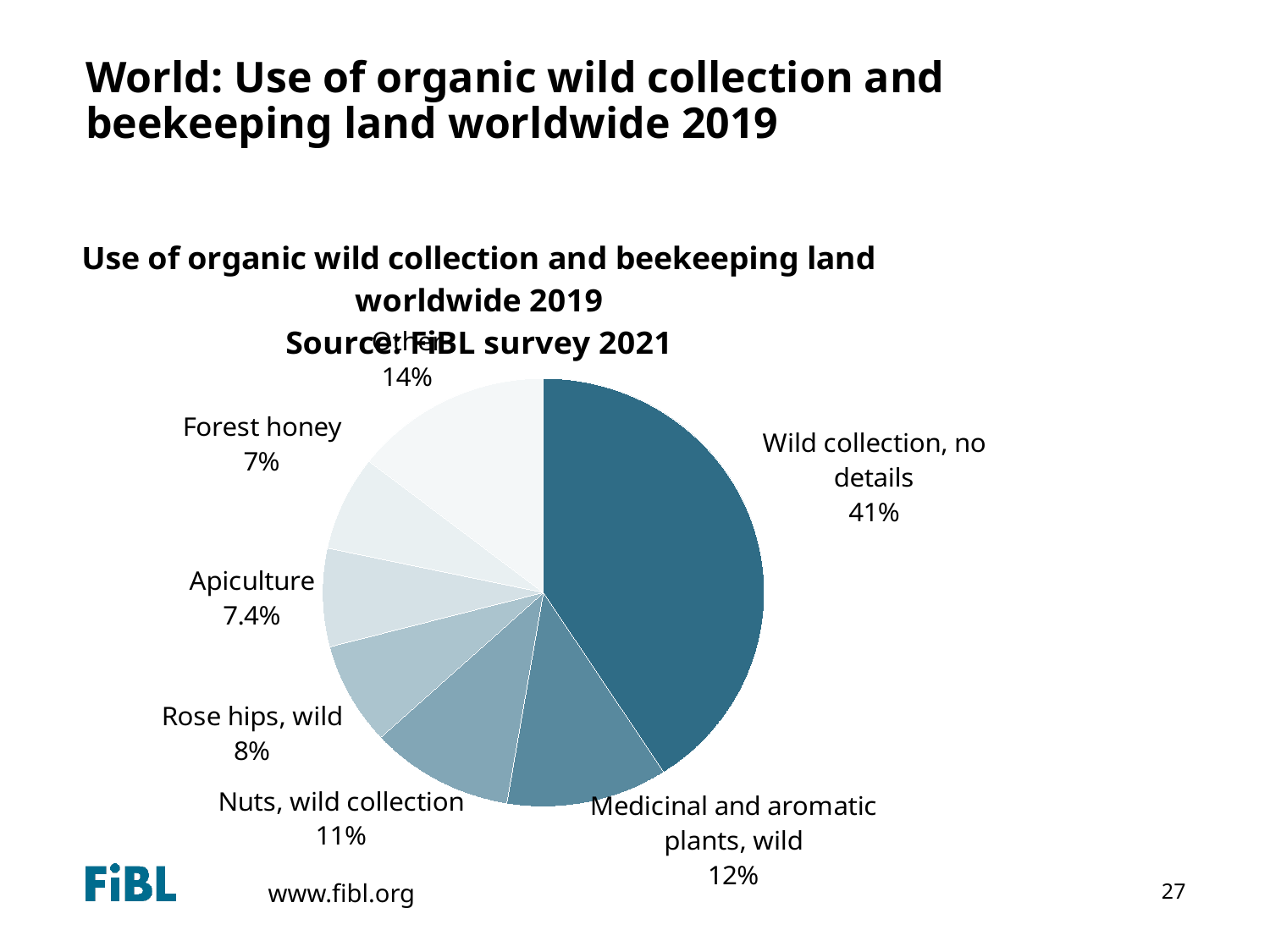
What kind of chart is shown on the slide? pie chart Which has the larger share: 'Nuts, wild collection' or 'Rose hips, wild'? Nuts, wild collection Which labelled category has the smallest share of the pie? Forest honey What share of the pie is labelled for 'Wild collection, no details'? 41% What percentage is shown for 'Nuts, wild collection'? 11% How many slices does the pie chart have? 7 Which category has the largest share of the pie? Wild collection, no details What percentage is shown for 'Rose hips, wild'? 8% How many percentage points larger is the share for 'Wild collection, no details' than for 'Medicinal and aromatic plants, wild'? 29 percentage points What percentage is shown for 'Medicinal and aromatic plants, wild'? 12% What percentage is shown for 'Forest honey'? 7% What percentage is shown for 'Apiculture'? 7.4%